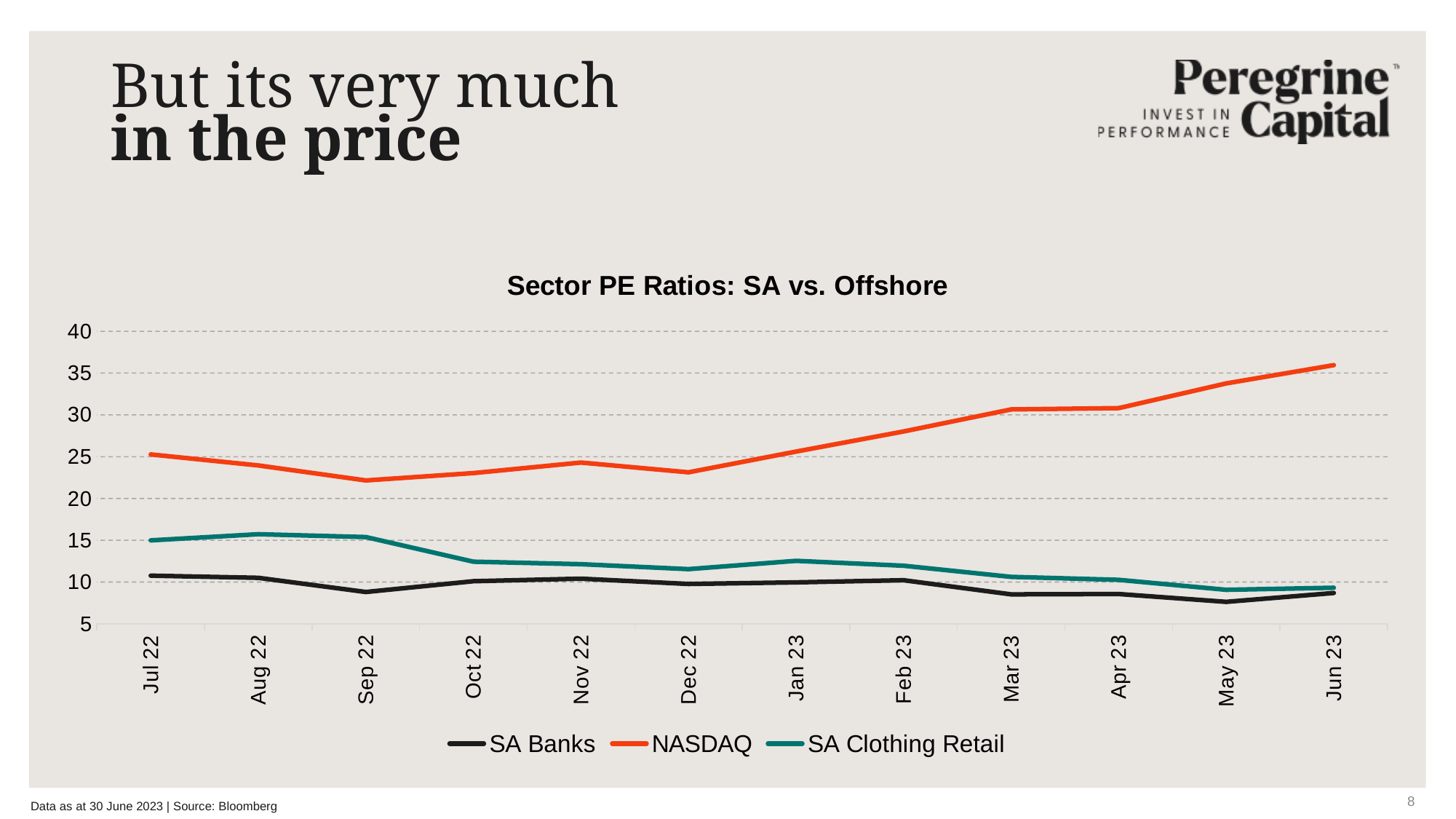
In which month is the SA Banks PE ratio lowest? May 23 Is the NASDAQ PE ratio in Jun 23 greater or less than 30? greater In which month is the NASDAQ PE ratio lowest? Sep 22 Does the NASDAQ PE ratio rise or fall from Dec 22 to Jun 23? rise How many series does the legend list? 3 In Oct 22, which is higher: SA Clothing Retail or SA Banks? SA Clothing Retail How many months are shown on the x axis? 12 In which month is the NASDAQ PE ratio highest? Jun 23 Which series has the highest PE ratio in Jun 23? NASDAQ What is the title of the chart? Sector PE Ratios: SA vs. Offshore What kind of chart is shown on the slide? Line chart Is the SA Clothing Retail PE ratio in Oct 22 greater or less than 15? less